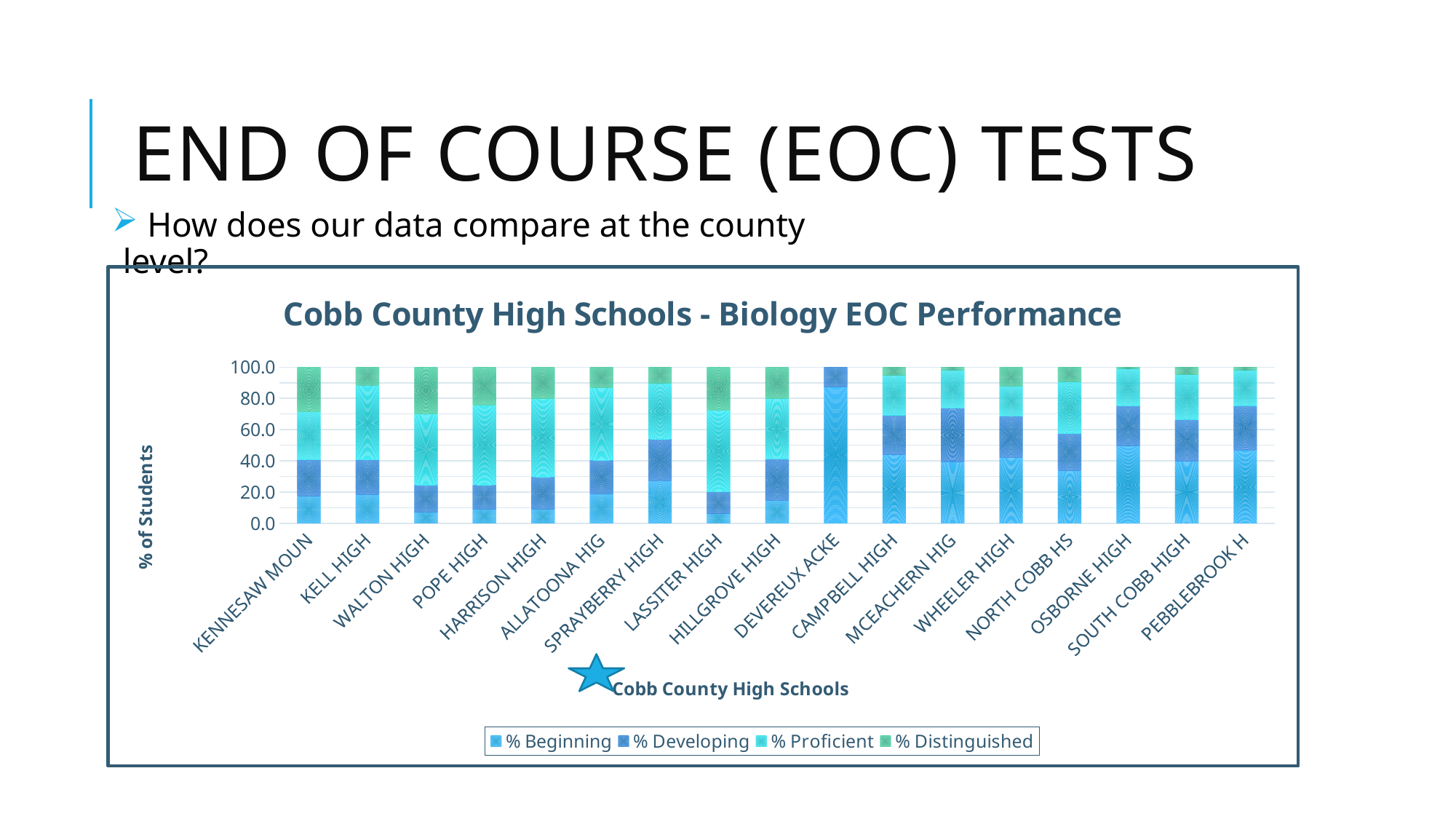
Which school has a larger % Beginning segment, OSBORNE HIGH or WALTON HIGH? OSBORNE HIGH Which school has the largest % Beginning segment? DEVEREUX ACKE What type of chart is shown on the slide? Stacked bar chart Is the % Beginning value for OSBORNE HIGH greater or less than 40? greater Is the % Beginning value for DEVEREUX ACKE greater or less than 80? greater Which school has a larger % Beginning segment, DEVEREUX ACKE or KELL HIGH? DEVEREUX ACKE How many schools are shown along the x axis of the chart? 17 How many series does the legend list? 4 Is the % Beginning value for LASSITER HIGH greater or less than 20? less What is the title of the chart? Cobb County High Schools - Biology EOC Performance What is the label on the vertical axis of the chart? % of Students